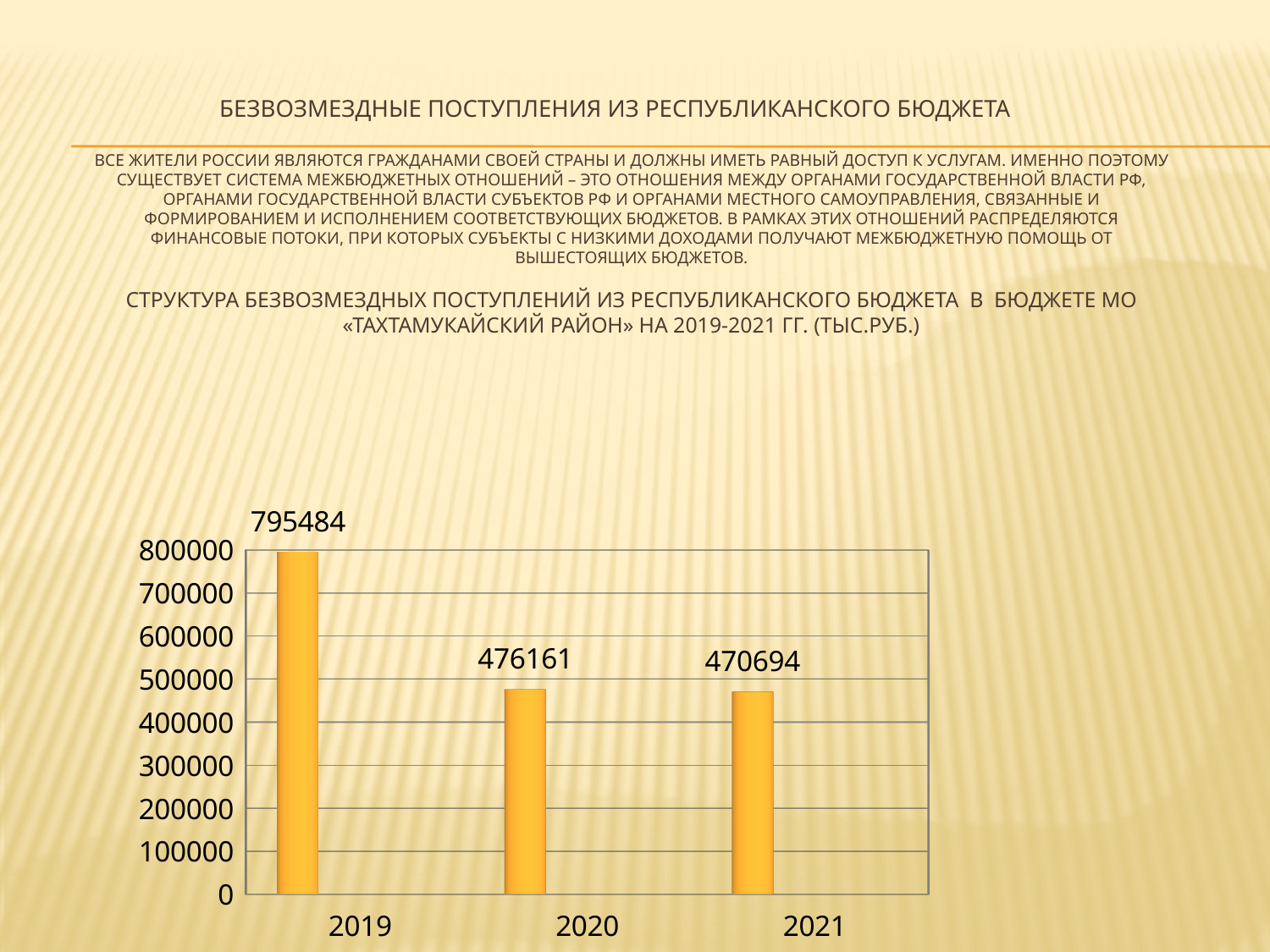
Which year has the lowest value? 2021 What is the value for 2020? 476161 Is the value for 2020 greater or less than 500000? less Which is larger, the value for 2019 or the value for 2021? 2019 Which year has the highest value? 2019 What is the value for 2021? 470694 How many years are shown on the x axis? 3 What is the difference between the values for 2020 and 2021? 5467 What is the difference between the values for 2019 and 2020? 319323 What kind of chart is shown on the slide? bar chart What is the value for 2019? 795484 Do the values rise or fall from 2019 to 2021? fall